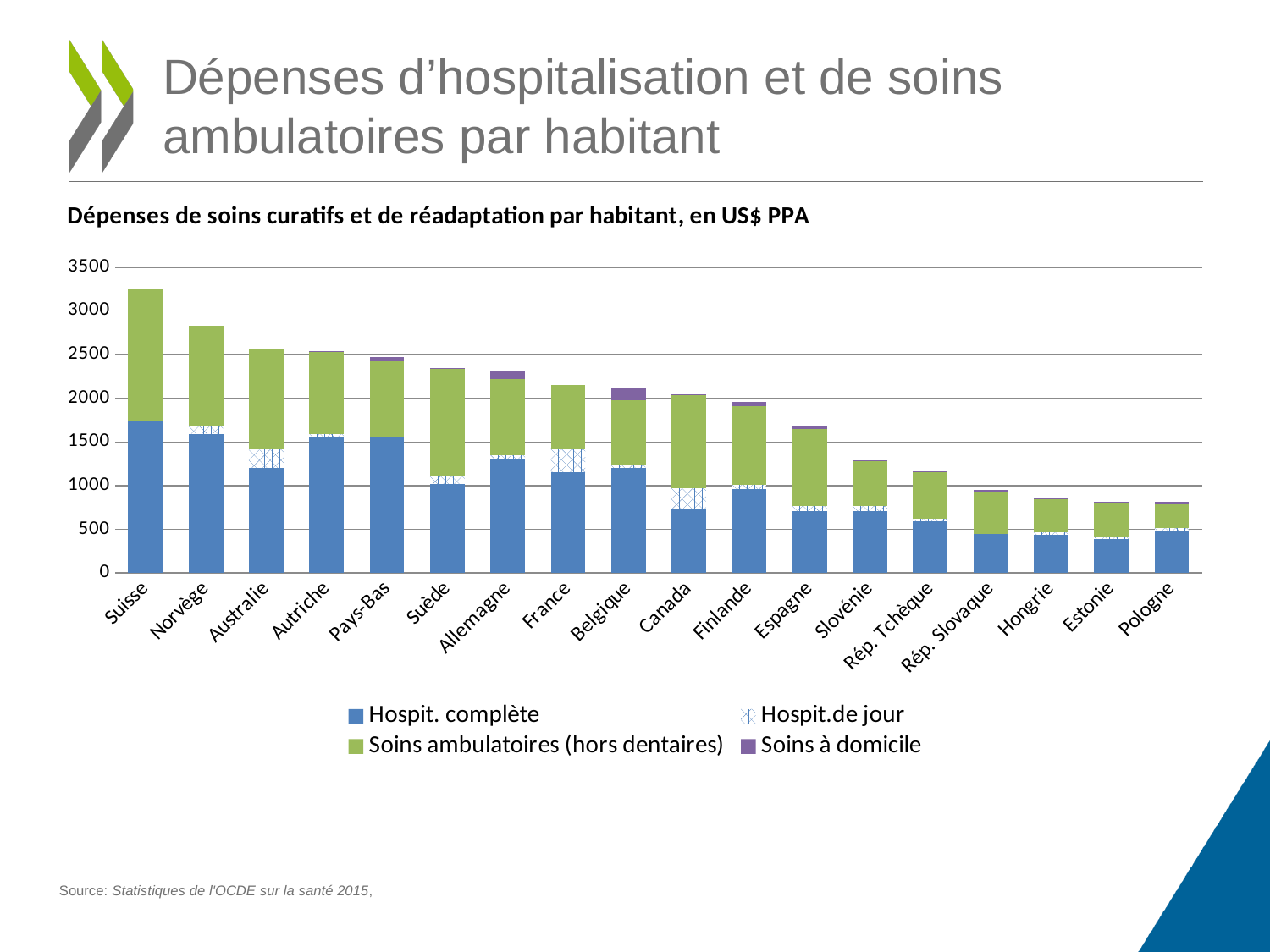
Which series is shown in green in the chart legend? Soins ambulatoires (hors dentaires) What kind of chart is shown on the slide? Stacked bar chart What is the title of the chart? Dépenses de soins curatifs et de réadaptation par habitant, en US$ PPA Do the total bars generally rise or fall moving from left to right along the x axis? fall How many countries are shown on the x axis of the chart? 18 Which country has the highest total bar in the chart? Suisse How many series does the chart legend list? 4 Is the total bar for Suisse greater or less than 3000? greater Is the Hospit. complète value for Suisse greater or less than 1500? greater Which has the larger total bar, Suisse or Norvège? Suisse Is the total bar for Pologne greater or less than 1000? less